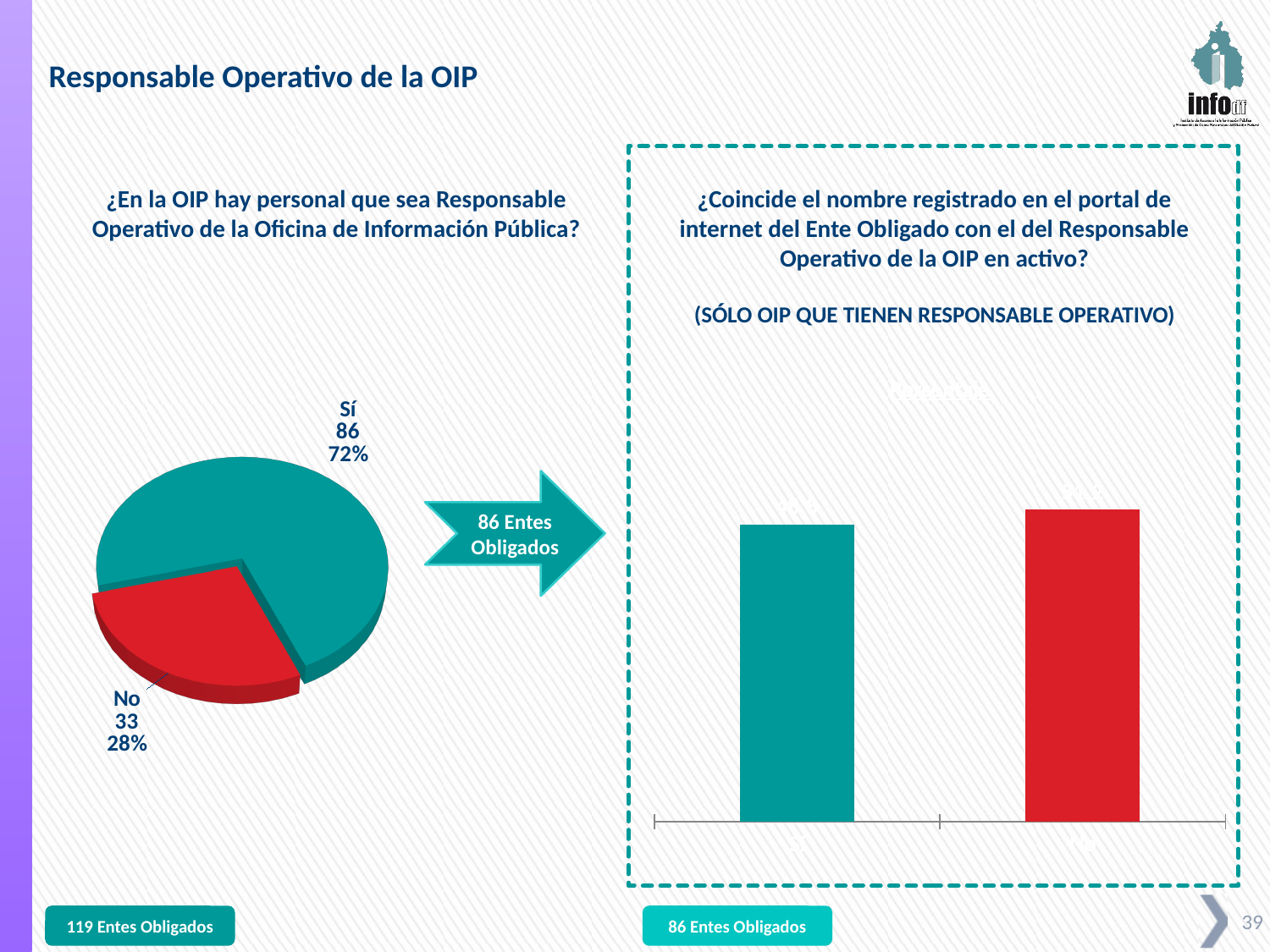
On the pie chart on the left, how many slices are there? 2 On the pie chart on the left, which slice is the largest? Sí What kind of chart is shown inside the dashed box on the right side of the slide? Bar chart What kind of chart is shown on the left side of the slide? Pie chart On the pie chart on the left, what is the difference between the "Sí" value and the "No" value? 53 On the pie chart on the left, what value is shown for the "Sí" slice? 86 On the pie chart on the left, which slice is the smallest? No On the pie chart on the left, what percentage share does the "No" slice have? 28% On the pie chart on the left, what percentage share does the "Sí" slice have? 72% On the pie chart on the left, what value is shown for the "No" slice? 33 On the bar chart on the right, how many bars are plotted? 2 On the bar chart on the right, which bar is taller, the teal bar on the left or the red bar on the right? The red bar on the right